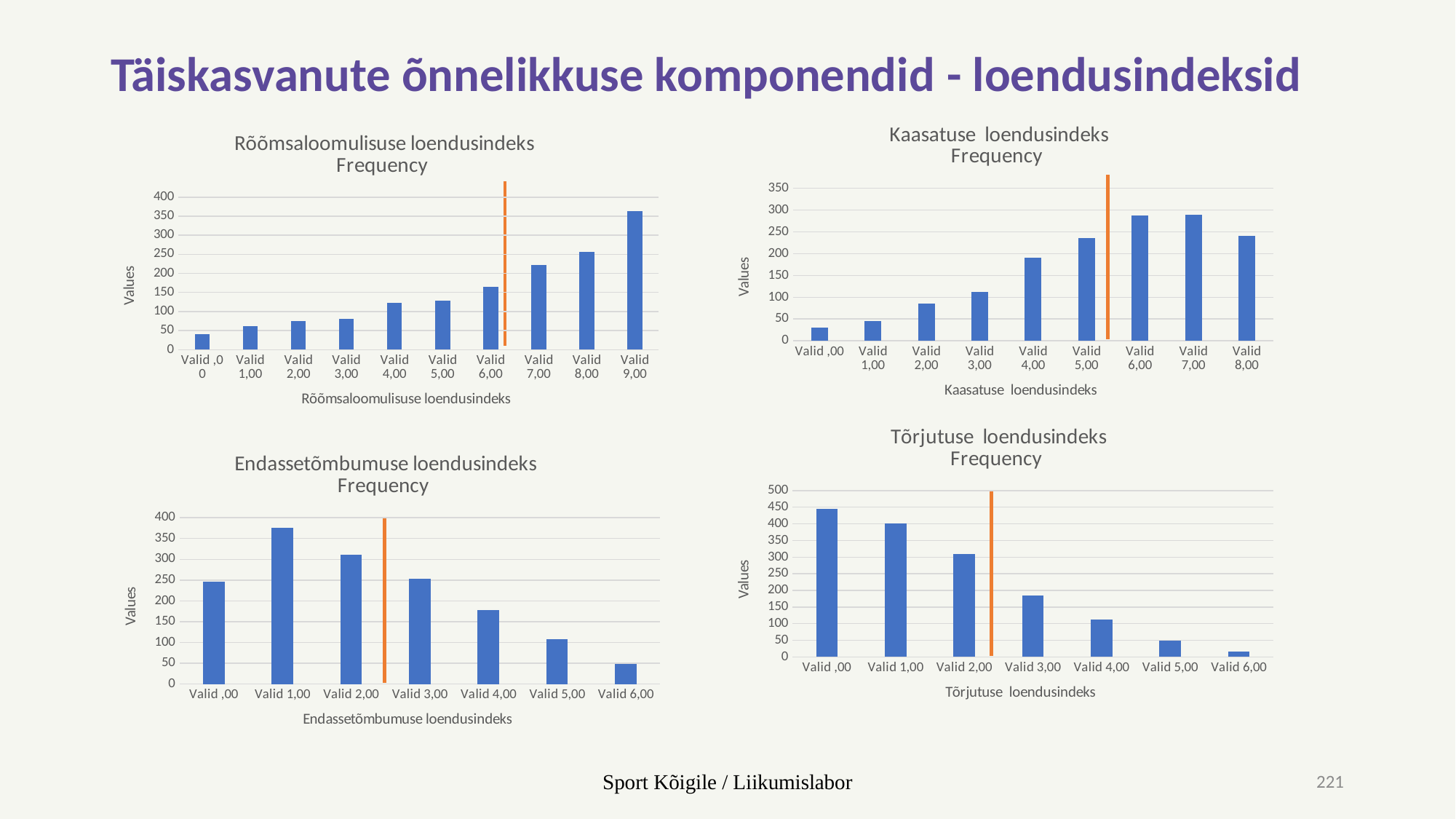
How many categories are shown in the Rõõmsaloomulisuse loendusindeks Frequency chart? 10 In the Rõõmsaloomulisuse loendusindeks Frequency chart, which category has the lowest value? Valid ,00 What kind of chart is the Tõrjutuse loendusindeks Frequency chart? bar chart In the Rõõmsaloomulisuse loendusindeks Frequency chart, is the value for Valid 7,00 greater or less than 200? greater In the Tõrjutuse loendusindeks Frequency chart, which is larger, the value for Valid ,00 or the value for Valid 3,00? Valid ,00 In the Rõõmsaloomulisuse loendusindeks Frequency chart, do the values rise or fall from Valid ,00 to Valid 9,00? rise In the Endassetõmbumuse loendusindeks Frequency chart, is the value for Valid 4,00 greater or less than 200? less In the Endassetõmbumuse loendusindeks Frequency chart, which category has the highest value? Valid 1,00 In the Kaasatuse loendusindeks Frequency chart, which category has the lowest value? Valid ,00 In the Rõõmsaloomulisuse loendusindeks Frequency chart, which category has the highest value? Valid 9,00 How many categories are shown in the Kaasatuse loendusindeks Frequency chart? 9 In the Kaasatuse loendusindeks Frequency chart, is the value for Valid 4,00 greater or less than 200? less